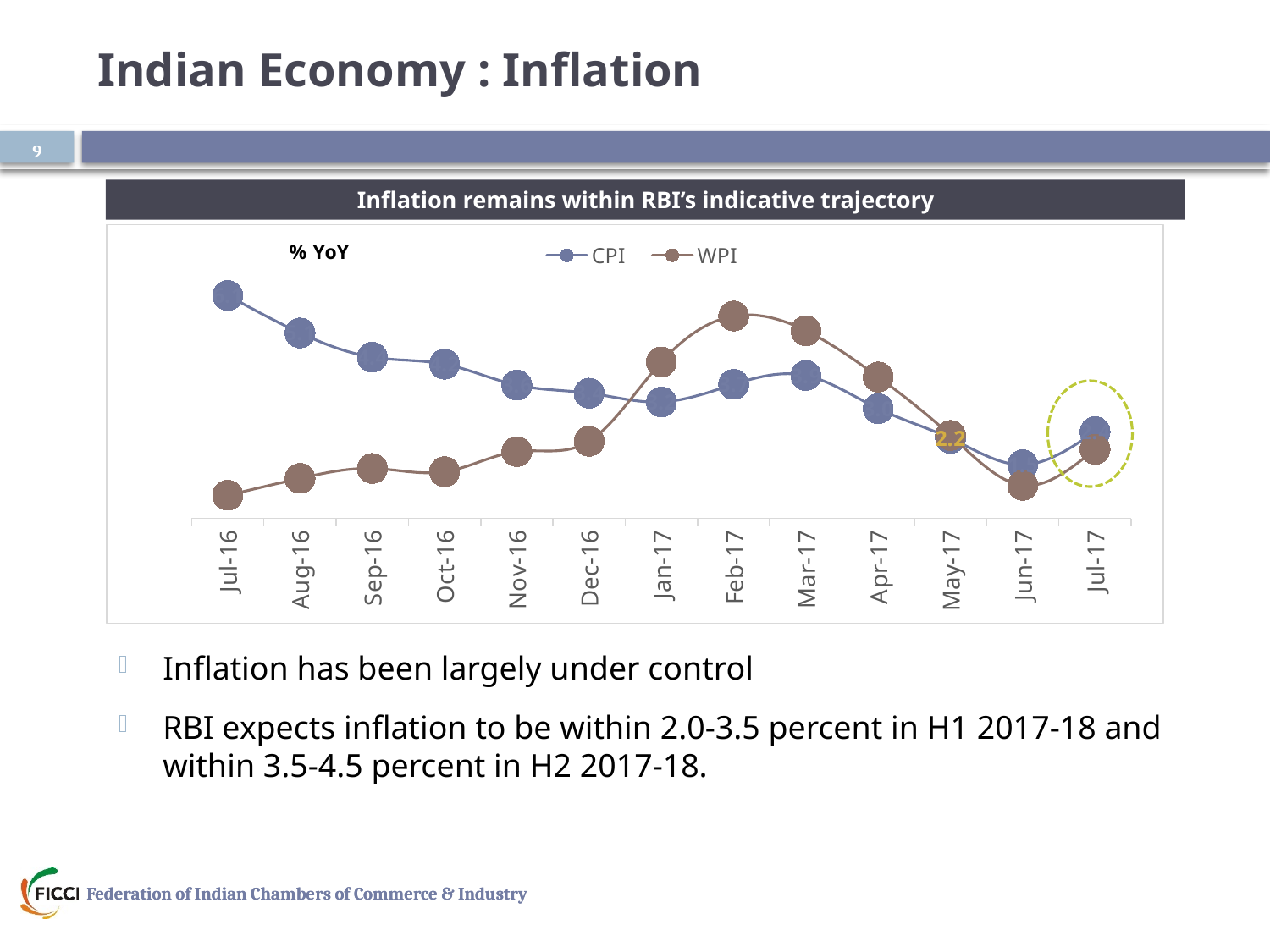
Does the CPI series rise or fall from Jul-16 to Dec-16? Fall What kind of chart is shown on the slide? Line chart How many months are plotted along the x axis of the chart? 13 Which two series are shown in the chart legend? CPI and WPI In which month does the WPI series reach its highest point? Feb-17 In which month is the CPI series at its highest? Jul-16 What is the title of the chart? Inflation remains within RBI's indicative trajectory How many series does the chart legend list? 2 In which month is the CPI series at its lowest? Jun-17 In Feb-17, which series is higher, CPI or WPI? WPI Does the WPI series rise or fall from Jul-16 to Feb-17? Rise In Jul-16, which series is higher, CPI or WPI? CPI